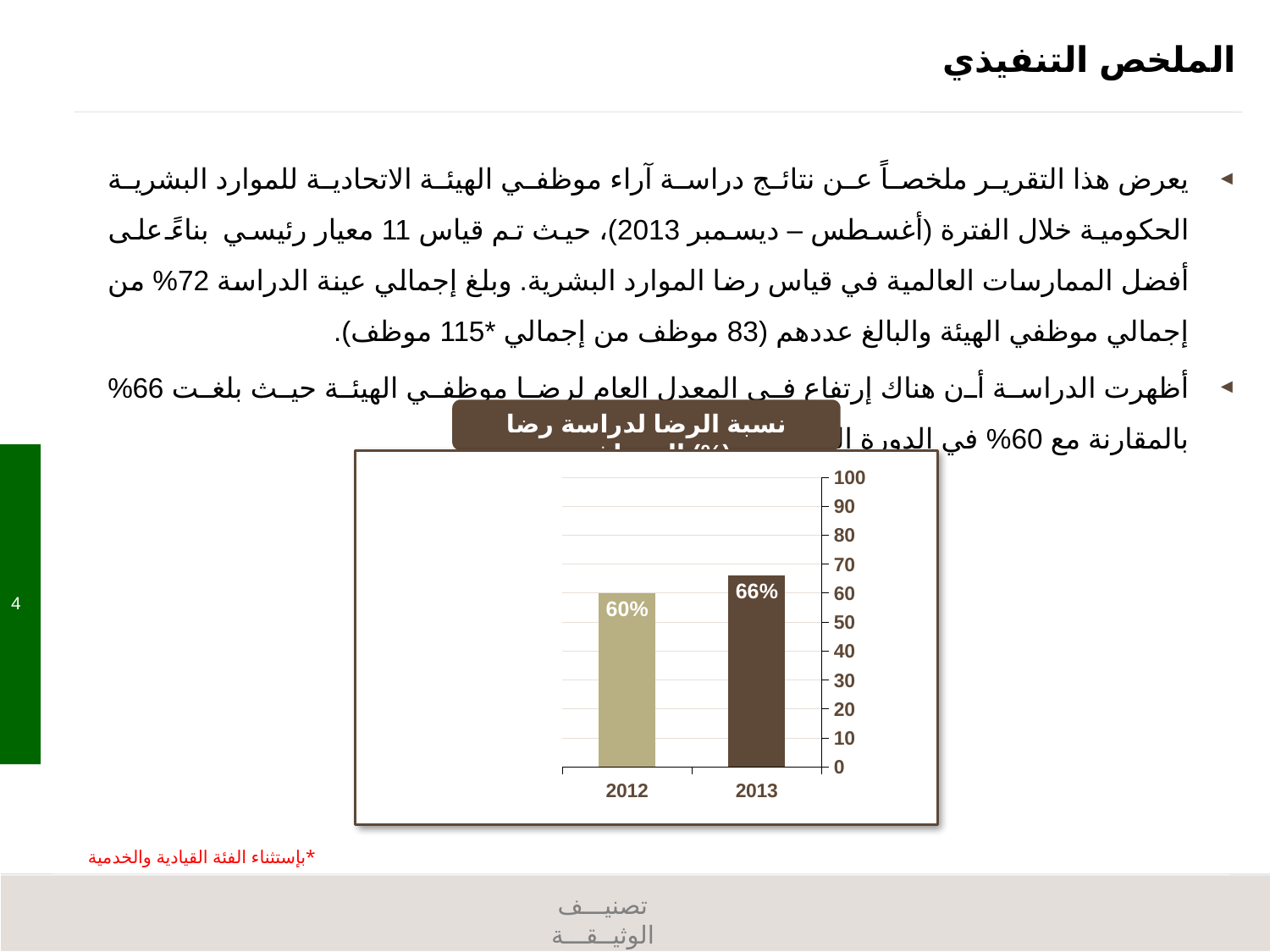
What is the difference between the values for 2013 and 2012? 6% What is the value for 2013? 66% What is the maximum value shown on the vertical axis of the chart? 100 Is the value for 2013 greater or less than 70? less Which is larger, the value for 2012 or the value for 2013? 2013 How many bars are shown in the chart? 2 What is the value for 2012? 60% Which year has the lowest value? 2012 Is the value for 2012 greater or less than 50? greater Do the values rise or fall from 2012 to 2013? rise Which year has the highest value? 2013 What kind of chart is shown on the slide? bar chart